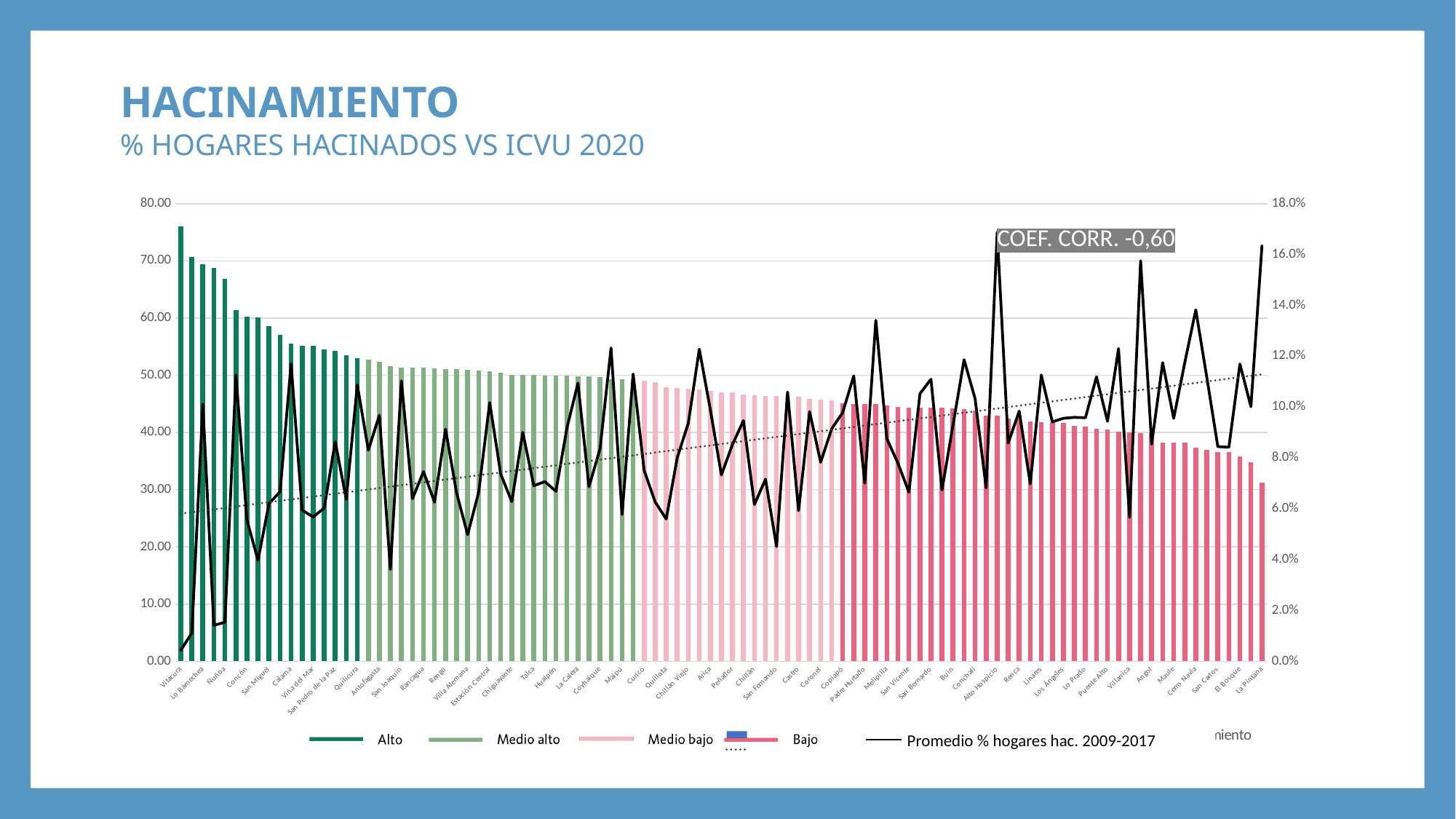
How many bar colour categories (Alto, Medio alto, Medio bajo, Bajo) does the legend list? 4 Do the bar values rise or fall from left to right along the x axis? Fall Is the bar value for La Pintana greater or less than 40.00? less Is the bar value for Concón greater or less than 70.00? less Which comuna has the shortest bar (lowest ICVU value)? La Pintana What correlation coefficient is printed on the chart? -0,60 Is the bar value for Vitacura greater or less than 70.00? greater What kind of chart is shown on the slide? A combined bar and line chart Which comuna has the tallest bar (highest ICVU value)? Vitacura Which has the larger bar value, Vitacura or La Pintana? Vitacura